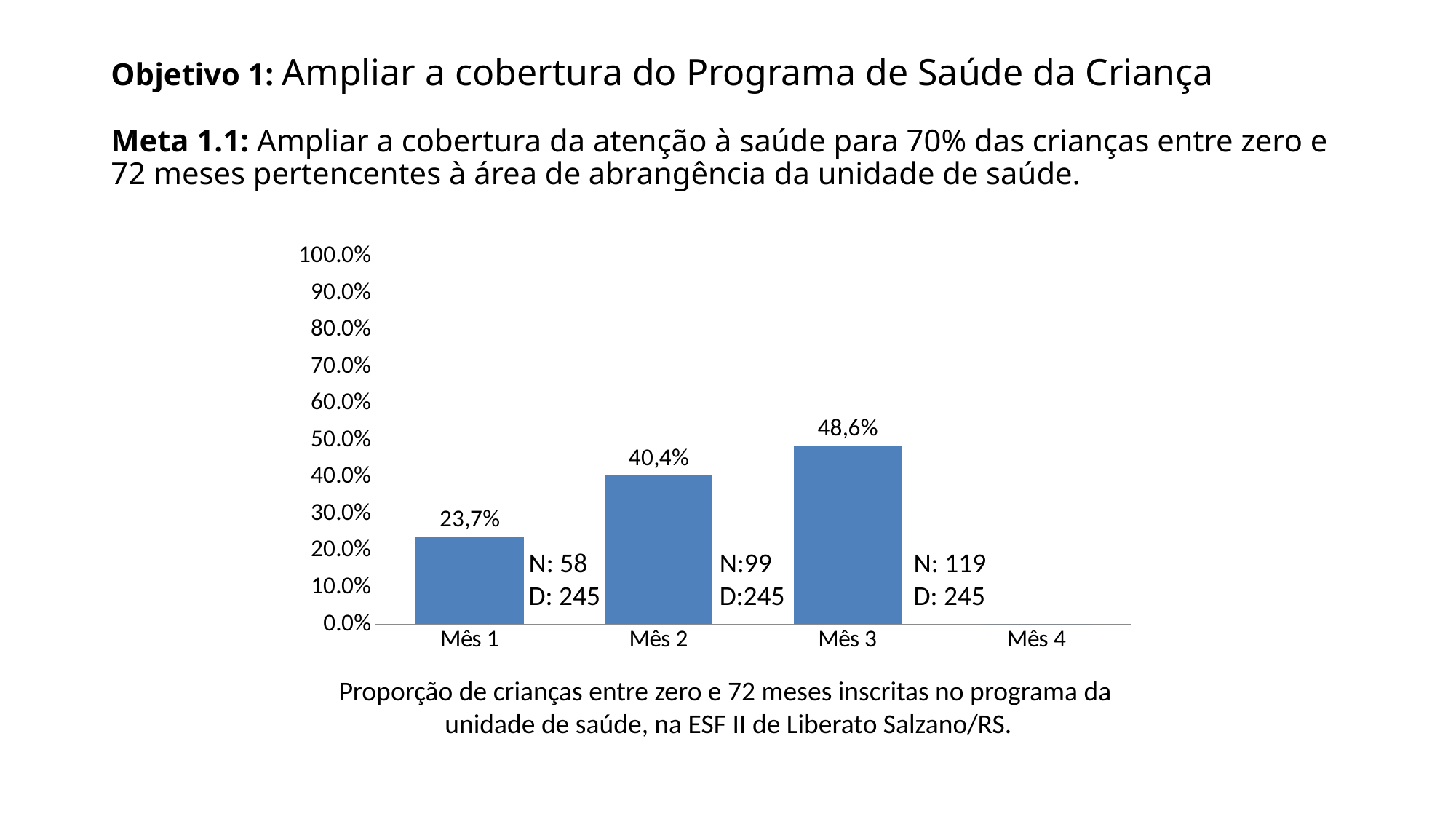
What is the value for Mês 3? 48,6% Do the values rise or fall from Mês 1 to Mês 3? rise What is the difference between the values for Mês 2 and Mês 1? 16,7% Which month has the highest value? Mês 3 Which is larger, the value for Mês 2 or the value for Mês 3? Mês 3 What is the value for Mês 1? 23,7% Is the value for Mês 1 greater or less than 20%? greater What is the difference between the values for Mês 3 and Mês 1? 24,9% What kind of chart is shown on the slide? bar chart How many bars are plotted in the chart? 3 What is the value for Mês 2? 40,4% Which month with a plotted bar has the lowest value? Mês 1